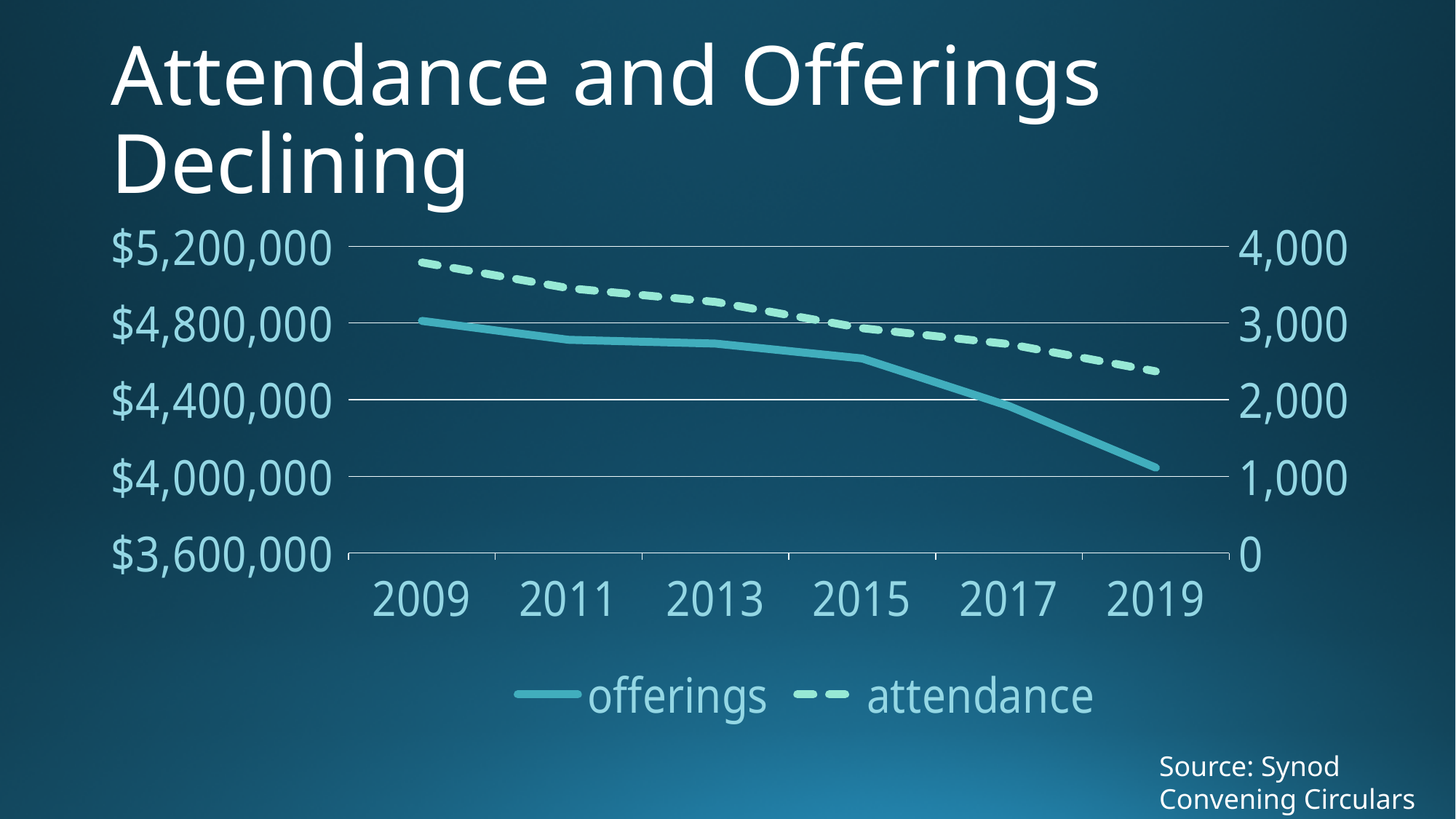
Is the attendance value for 2019 greater or less than 3,000? less How many years are labelled on the x axis? 6 What is the title of the slide? Attendance and Offerings Declining Is the offerings value for 2013 greater or less than $4,400,000? greater Do offerings rise or fall from 2009 to 2019? fall How many series does the legend list? 2 Does attendance rise or fall from 2009 to 2019? fall What kind of chart is shown on the slide? line chart Is the attendance value for 2019 greater or less than 2,000? greater Which series is drawn with a dashed line? attendance